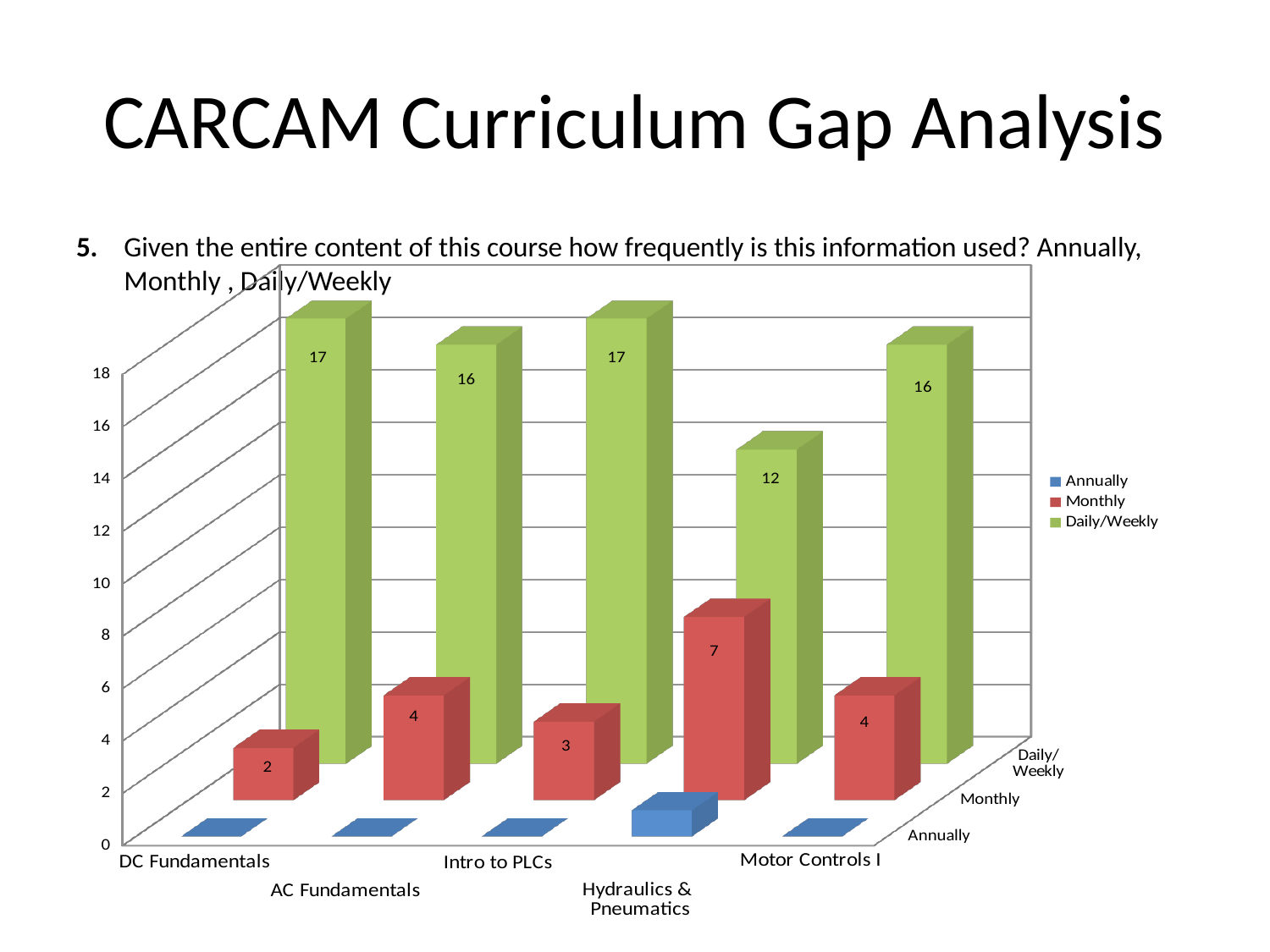
What is the Monthly value for Hydraulics & Pneumatics? 7 Which course has the lowest Daily/Weekly value? Hydraulics & Pneumatics Which is larger, the Monthly value for AC Fundamentals or the Monthly value for DC Fundamentals? AC Fundamentals What kind of chart is shown on the slide? Bar chart What is the Daily/Weekly value for Motor Controls I? 16 Which course has the highest Monthly value? Hydraulics & Pneumatics What is the Monthly value for Intro to PLCs? 3 What is the difference between the Daily/Weekly value for Intro to PLCs and the Daily/Weekly value for Hydraulics & Pneumatics? 5 How many series does the legend list? 3 What is the Daily/Weekly value for DC Fundamentals? 17 Which colour represents the Daily/Weekly series in the legend? Green How many courses are shown on the x axis? 5